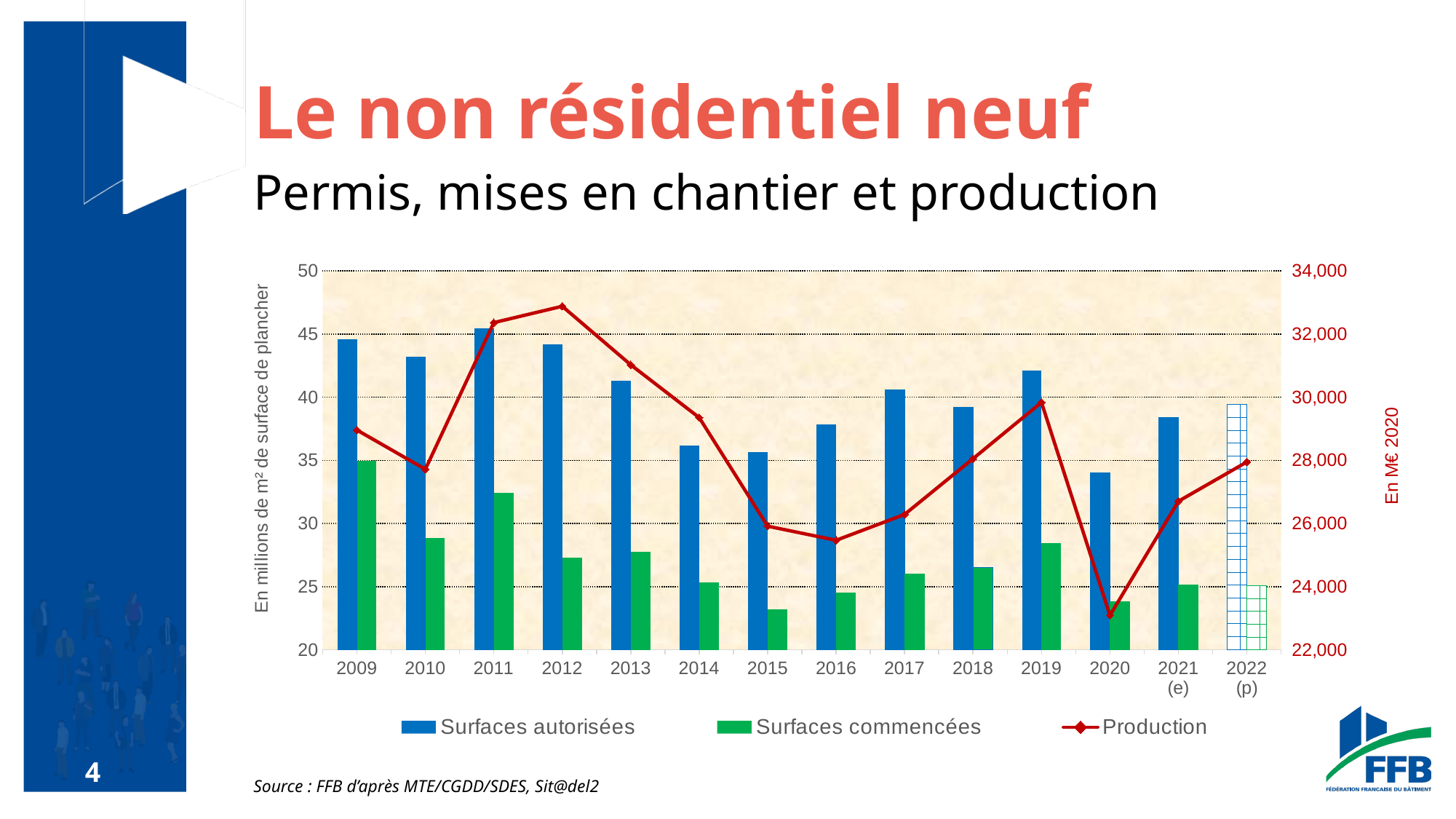
Which year has the larger Surfaces autorisées value, 2018 or 2019? 2019 Does the Production line rise or fall between 2012 and 2016? It falls What kind of chart is shown on the slide? A combined bar and line chart How many series does the legend list? 3 Is the value for Surfaces autorisées in 2020 greater or less than 35? less How many years are shown on the x axis? 14 In which year does the Production line reach its lowest point? 2020 In which year is the Surfaces autorisées bar the lowest? 2020 In which year is the Surfaces autorisées bar the highest? 2011 Is the value for Production in 2020 greater or less than 24,000? less In which year does the Production line reach its highest point? 2012 In which year is the Surfaces commencées bar the highest? 2009